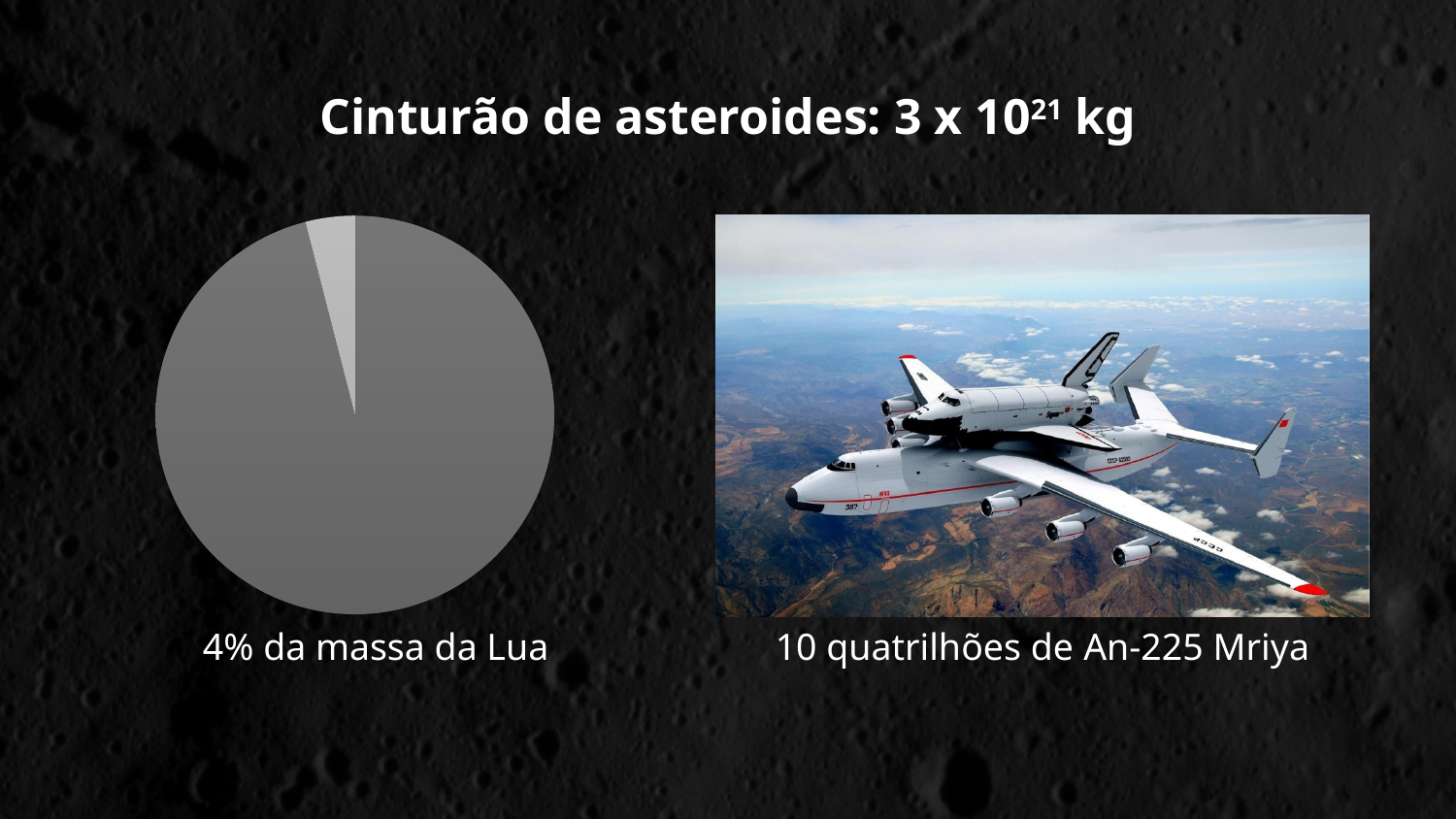
What kind of chart is shown on the left of the slide? Pie chart Which slice of the pie chart is larger, the dark grey one or the light grey one? The dark grey one What is the title at the top of the slide? Cinturão de asteroides: 3 x 10²¹ kg How many slices does the pie chart have? 2 According to the caption under the pie chart, what share of the Moon's mass does the asteroid belt represent? 4% Which slice of the pie chart is the smallest? The light grey slice What is the caption printed below the pie chart? 4% da massa da Lua